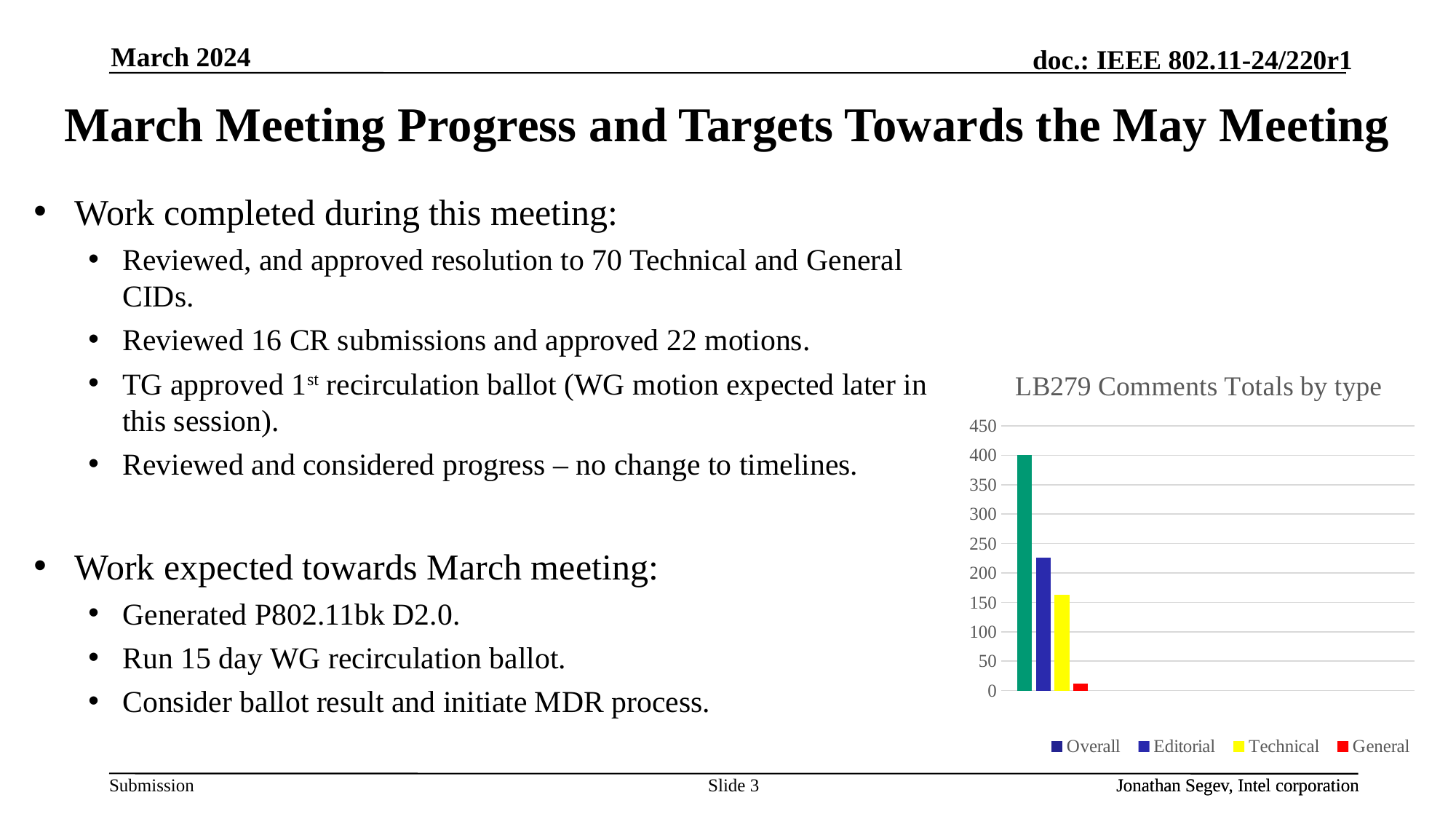
Is the value for General greater or less than 50? less Is the value for Editorial greater or less than 200? greater Is the value for Technical greater or less than 200? less How many series does the chart legend list? 4 What kind of chart is shown on the slide? bar chart Which is larger, the value for Editorial or the value for Technical? Editorial Which series has the highest value in the chart? Overall What is the title of the chart on the slide? LB279 Comments Totals by type Do the bar values rise or fall going from Overall to General across the chart? fall What is the highest value shown on the chart's vertical axis? 450 Which series has the lowest value in the chart? General